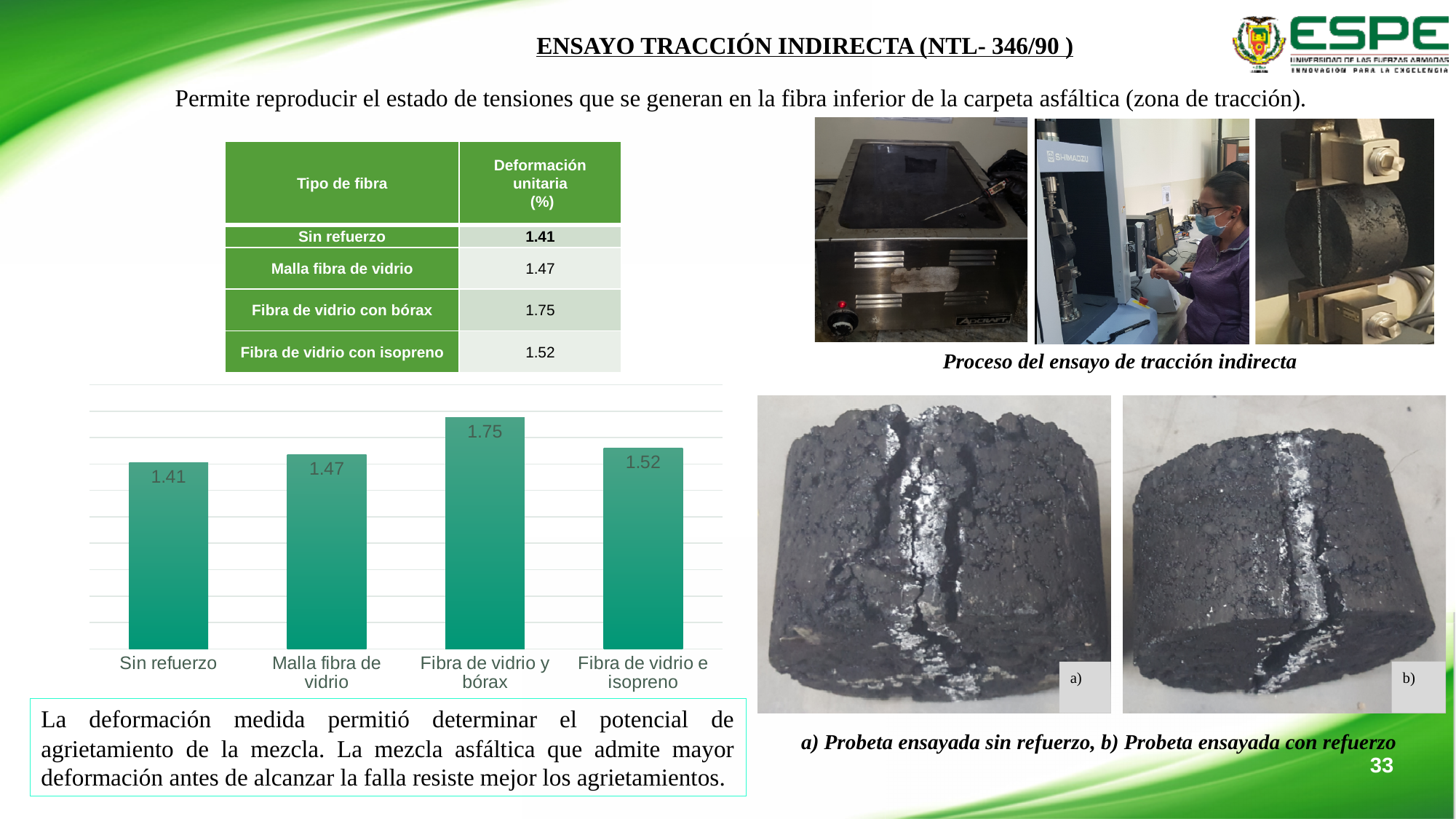
Which is larger in the bar chart, the value for Fibra de vidrio e isopreno or the value for Malla fibra de vidrio? Fibra de vidrio e isopreno What is the difference between the values for Fibra de vidrio y bórax and Sin refuerzo in the bar chart? 0.34 What is the value for Fibra de vidrio e isopreno in the bar chart? 1.52 What is the value for Fibra de vidrio y bórax in the bar chart? 1.75 What kind of chart is shown on the slide? Bar chart Which category has the lowest value in the bar chart? Sin refuerzo What is the value for Sin refuerzo in the bar chart? 1.41 What is the value for Malla fibra de vidrio in the bar chart? 1.47 What is the difference between the values for Fibra de vidrio e isopreno and Malla fibra de vidrio in the bar chart? 0.05 How many categories are shown in the bar chart? 4 What is the total of all four values shown in the bar chart? 6.15 Which category has the highest value in the bar chart? Fibra de vidrio y bórax